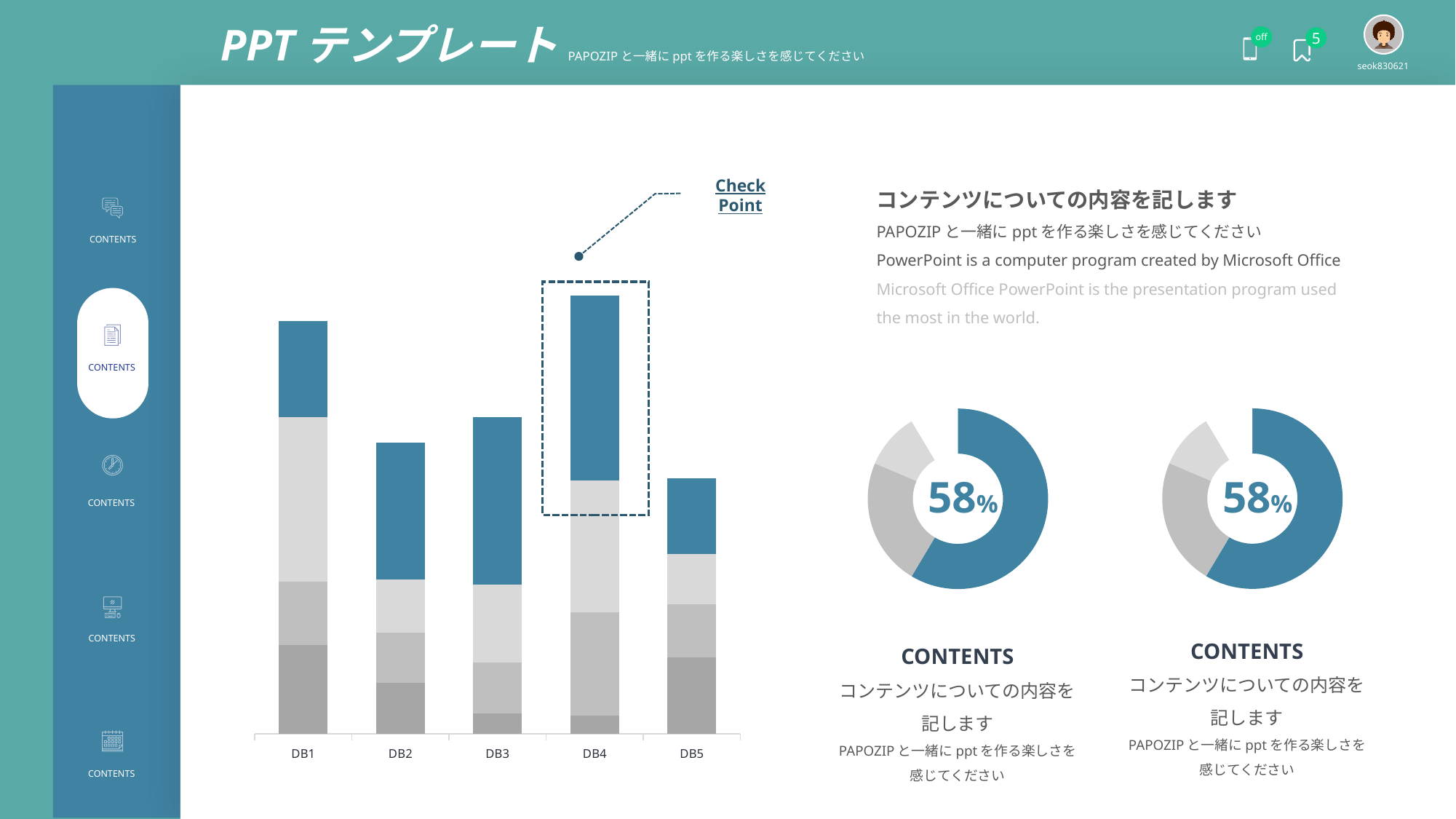
In the bar chart on the left, which category has the shortest bar? DB5 What kind of chart is the chart on the left of the slide with categories DB1 to DB5? stacked bar chart In the bar chart on the left, how many stacked segments does each bar have? 4 In the bar chart on the left, which bar is taller overall, DB1 or DB2? DB1 In the bar chart on the left, which category is enclosed by the dashed 'Check Point' box? DB4 In the bar chart on the left, which bar is taller overall, DB3 or DB5? DB3 What percentage is shown in the centre of the left donut chart? 58% In the bar chart on the left, which category has the tallest bar? DB4 How many donut charts are on the slide? 2 In the bar chart on the left, how many categories are shown on the x axis? 5 What percentage is shown in the centre of the right donut chart? 58% In the bar chart on the left, what colour is the topmost segment of each bar? blue